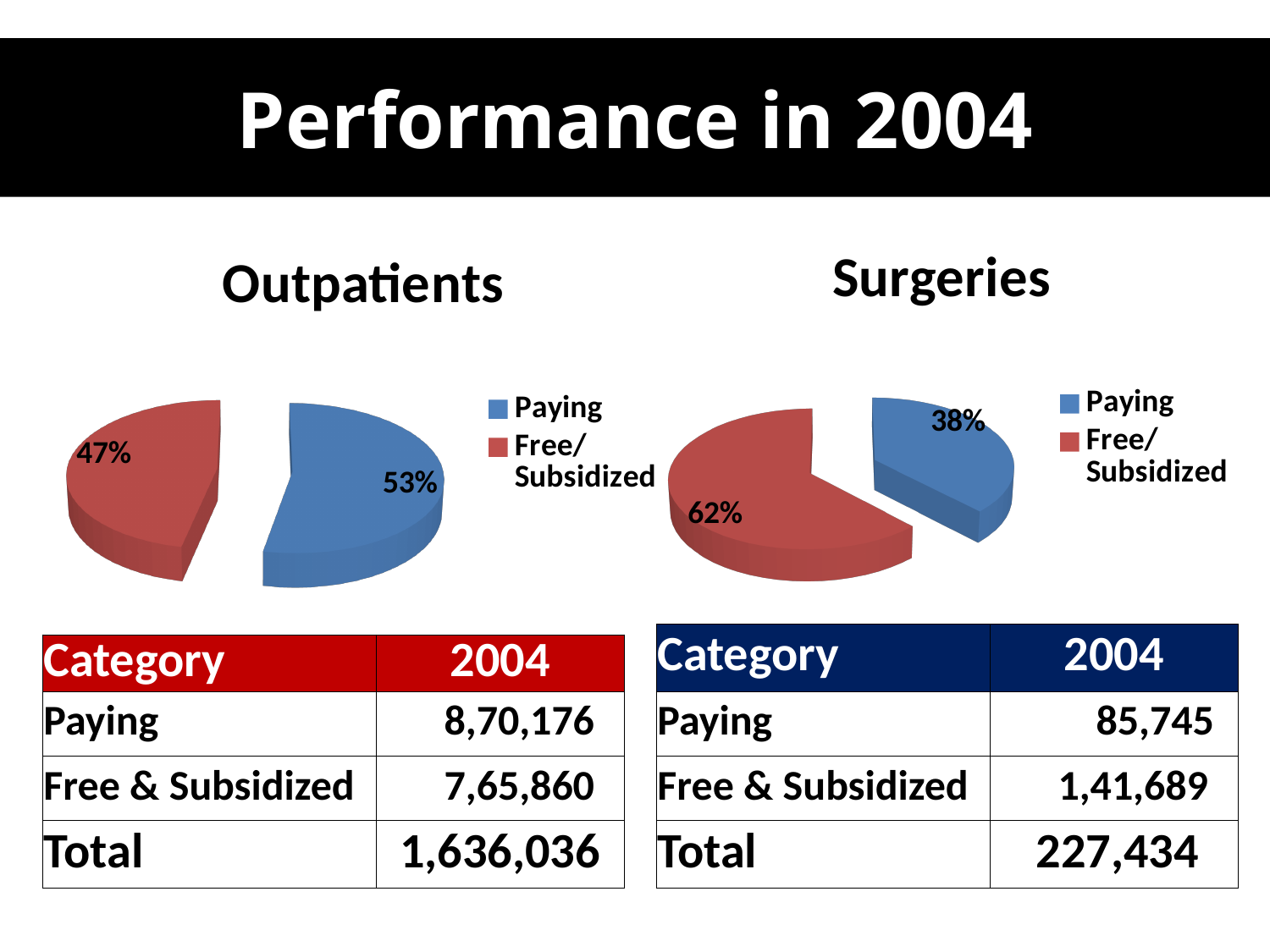
In the Outpatients pie chart, what share does the Paying slice have? 53% In the Surgeries pie chart, which slice is the smallest? Paying In the Surgeries pie chart, what is the difference in percentage points between the Free/Subsidized and Paying slices? 24 In the Surgeries pie chart, what share does the Free/Subsidized slice have? 62% How many slices does the Surgeries pie chart have? 2 In the Surgeries pie chart, which slice is larger, Paying or Free/Subsidized? Free/Subsidized In the Outpatients pie chart, which slice is the largest? Paying In the Surgeries pie chart, what share does the Paying slice have? 38% In the Outpatients pie chart, what colour is the Free/Subsidized slice? Red What type of chart is the Outpatients chart? Pie chart In the Outpatients pie chart, what is the difference in percentage points between the Paying and Free/Subsidized slices? 6